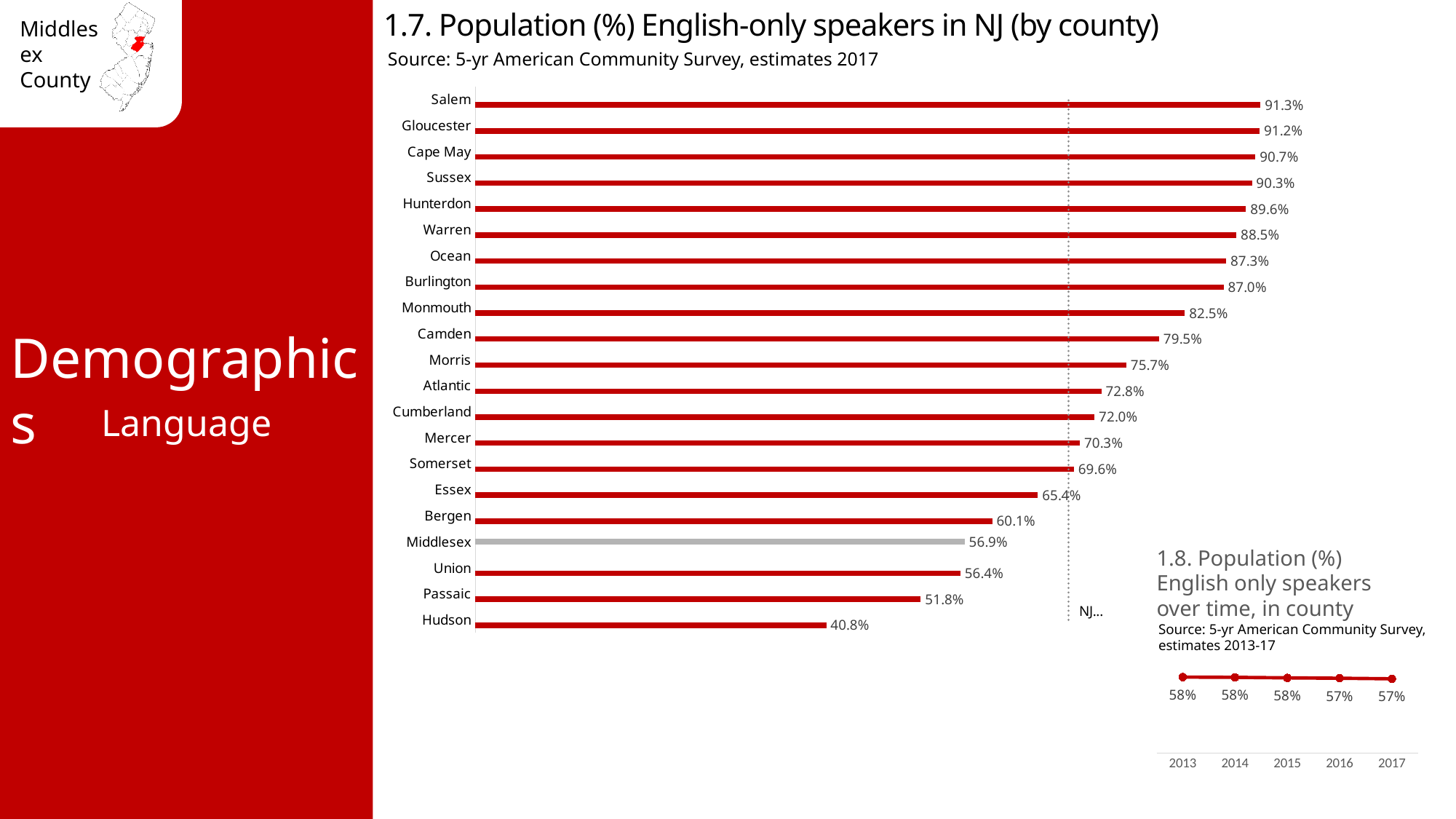
In chart 1.7 (Population (%) English-only speakers in NJ by county), how many counties are shown? 21 In chart 1.7 (Population (%) English-only speakers in NJ by county), what is the difference between Salem and Hudson? 50.5% In chart 1.7 (Population (%) English-only speakers in NJ by county), which county has the highest value? Salem In chart 1.8 (Population (%) English only speakers over time, in county), how many years are plotted? 5 In chart 1.8 (Population (%) English only speakers over time, in county), do the values rise or fall from 2013 to 2017? Fall In chart 1.7 (Population (%) English-only speakers in NJ by county), what is the difference between Monmouth and Camden? 3.0% In chart 1.7 (Population (%) English-only speakers in NJ by county), which county has the lowest value? Hudson In chart 1.7 (Population (%) English-only speakers in NJ by county), what is the value for Middlesex? 56.9% In chart 1.8 (Population (%) English only speakers over time, in county), what is the value for 2017? 57% What kind of chart is chart 1.7 (Population (%) English-only speakers in NJ by county)? Bar chart In chart 1.7 (Population (%) English-only speakers in NJ by county), which is larger, Bergen or Union? Bergen In chart 1.7 (Population (%) English-only speakers in NJ by county), what is the value for Hudson? 40.8%